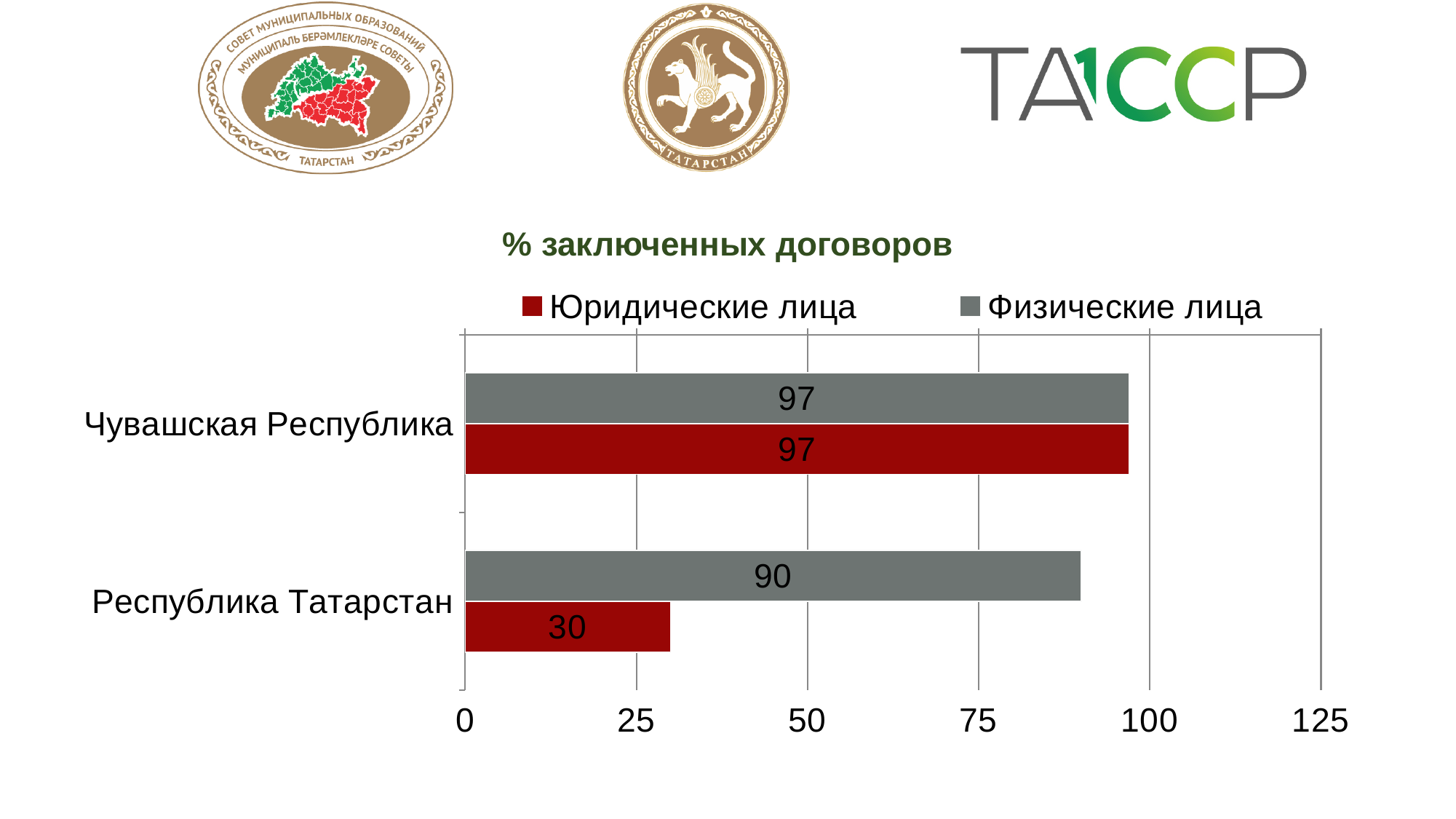
Which category has the highest value for Физические лица? Чувашская Республика What is the value for Физические лица in Республика Татарстан? 90 What is the value for Физические лица in Чувашская Республика? 97 Which category has the lowest value for Юридические лица? Республика Татарстан What is the value for Юридические лица in Чувашская Республика? 97 Which is larger in Республика Татарстан: Юридические лица or Физические лица? Физические лица How many series does the legend list? 2 How many categories are shown on the chart? 2 What is the value for Юридические лица in Республика Татарстан? 30 What is the difference between Физические лица and Юридические лица in Республика Татарстан? 60 What kind of chart is shown on the slide? Bar chart What is the difference between the Юридические лица values for Чувашская Республика and Республика Татарстан? 67